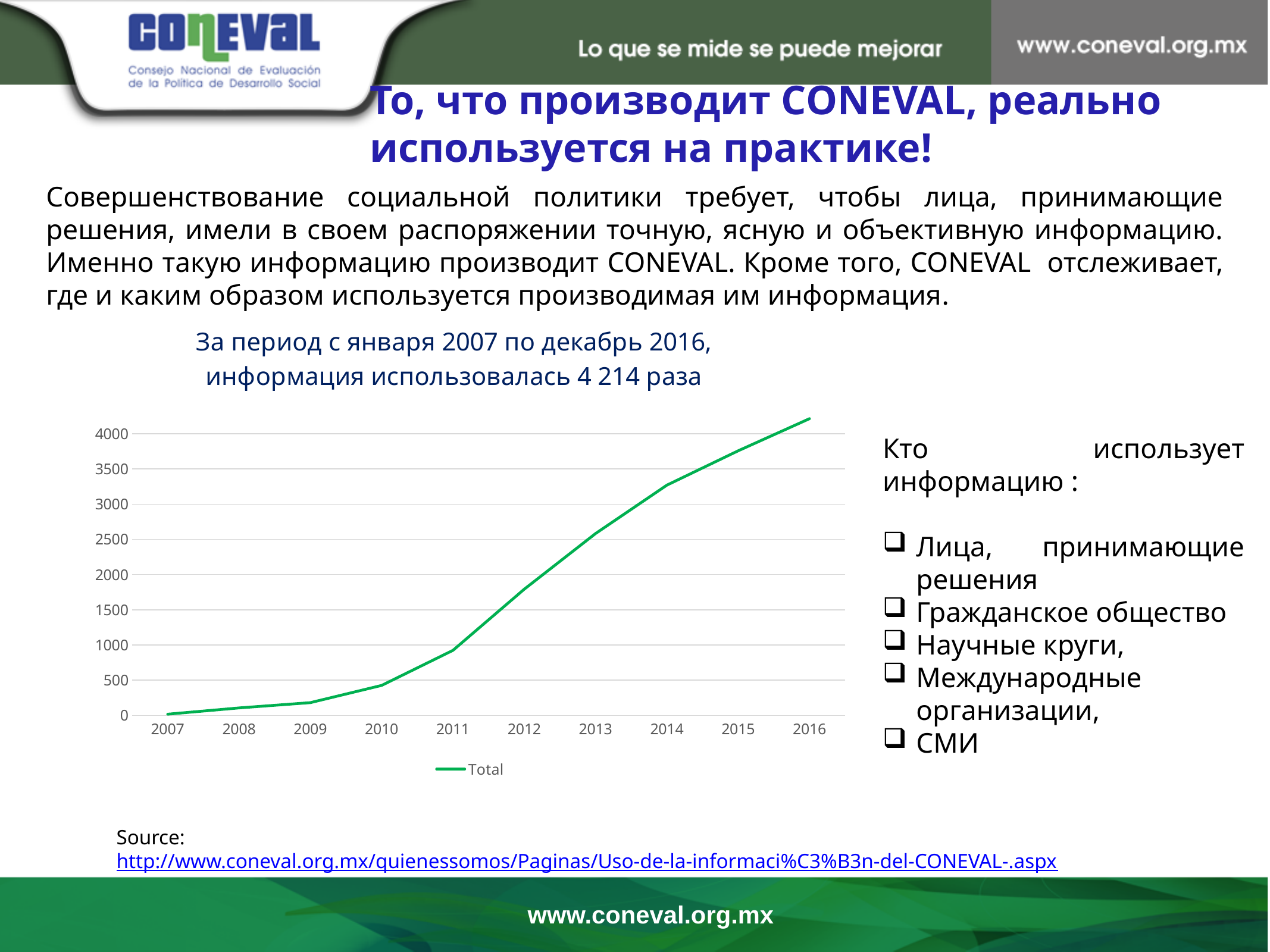
Which year has the lowest value in the chart? 2007 Do the values in the chart rise or fall from 2007 to 2016? rise How many years are plotted along the x axis of the chart? 10 Is the value for 2014 greater or less than 3000? greater Which year has the larger value, 2012 or 2014? 2014 How many series does the chart legend list? 1 What colour is the line plotted in the chart? green What kind of chart is shown on the slide? line chart What is the name of the series shown in the chart legend? Total Which year has the highest value in the chart? 2016 Is the value for 2009 greater or less than 500? less Is the value for 2016 greater or less than 4000? greater